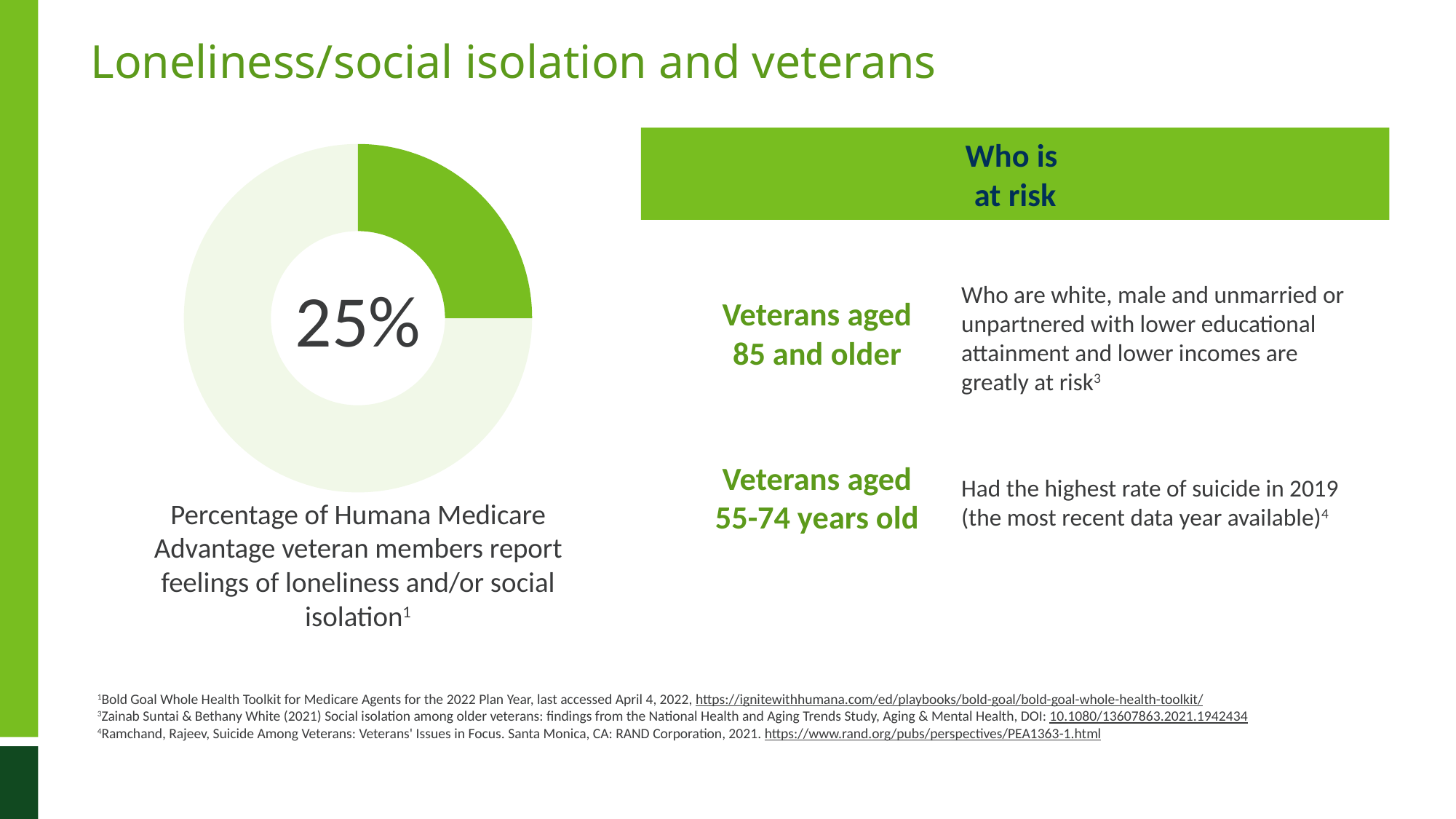
Which segment of the donut chart is larger, the green highlighted segment or the light segment? The light segment What share of the donut chart does the highlighted green segment represent? 25% What value is printed in the centre of the donut chart? 25% What kind of chart is shown on the left of the slide? Donut (pie) chart How many segments does the donut chart have? 2 What percentage of Humana Medicare Advantage veteran members report feelings of loneliness and/or social isolation, according to the chart? 25% What colour is the segment representing the 25% of veteran members reporting loneliness and/or social isolation? Green What does the donut chart's caption say the 25% represents? Percentage of Humana Medicare Advantage veteran members report feelings of loneliness and/or social isolation What share of the donut chart is taken up by the light, non-highlighted segment? 75%